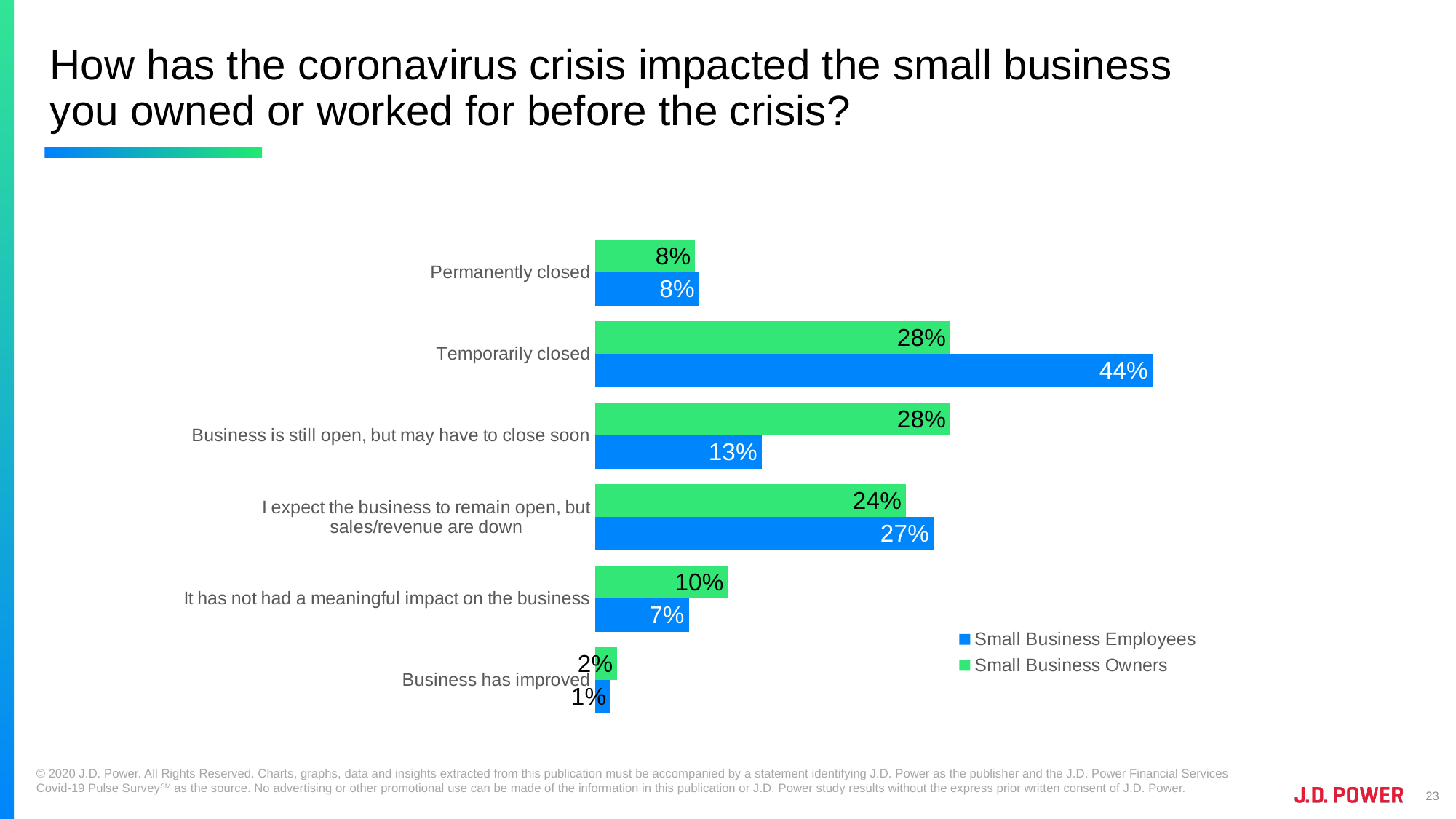
What percentage of Small Business Owners said the business is still open, but may have to close soon? 28% For 'Business is still open, but may have to close soon', which group has the larger value: Small Business Employees or Small Business Owners? Small Business Owners How many categories are shown on the chart? 6 What is the difference between Small Business Employees and Small Business Owners for 'Temporarily closed'? 16% What is the difference between Small Business Employees and Small Business Owners for 'It has not had a meaningful impact on the business'? 3% Which colour represents Small Business Owners in the chart? Green What percentage of Small Business Employees said their business was temporarily closed? 44% Which category has the highest value for Small Business Employees? Temporarily closed How many series does the legend list? 2 What percentage of Small Business Owners said it has not had a meaningful impact on the business? 10% Which category has the lowest value for Small Business Owners? Business has improved What kind of chart is shown on the slide? Bar chart